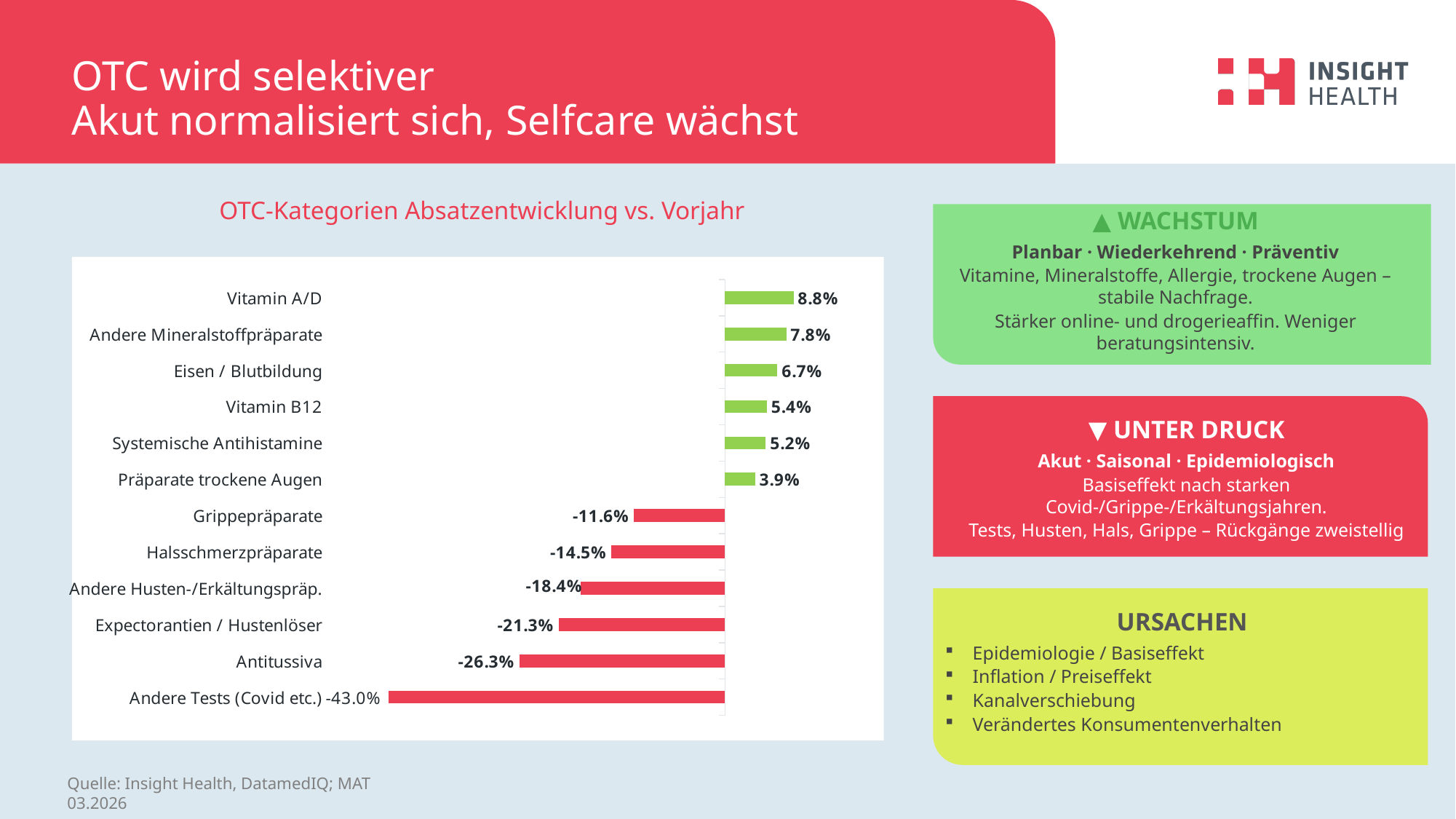
What colour are the bars for categories with negative values? Red What is the difference between the values for Vitamin A/D and Vitamin B12? 3.4 percentage points Which is larger, the value for Eisen / Blutbildung or the value for Präparate trockene Augen? Eisen / Blutbildung What is the value for Vitamin A/D? 8.8% What is the value for Andere Tests (Covid etc.)? -43.0% What is the title of the chart? OTC-Kategorien Absatzentwicklung vs. Vorjahr What kind of chart is shown on the slide? Bar chart Which category has the lowest value? Andere Tests (Covid etc.) What is the value for Systemische Antihistamine? 5.2% How many categories are shown in the chart? 12 What is the value for Antitussiva? -26.3% Which category has the highest value? Vitamin A/D